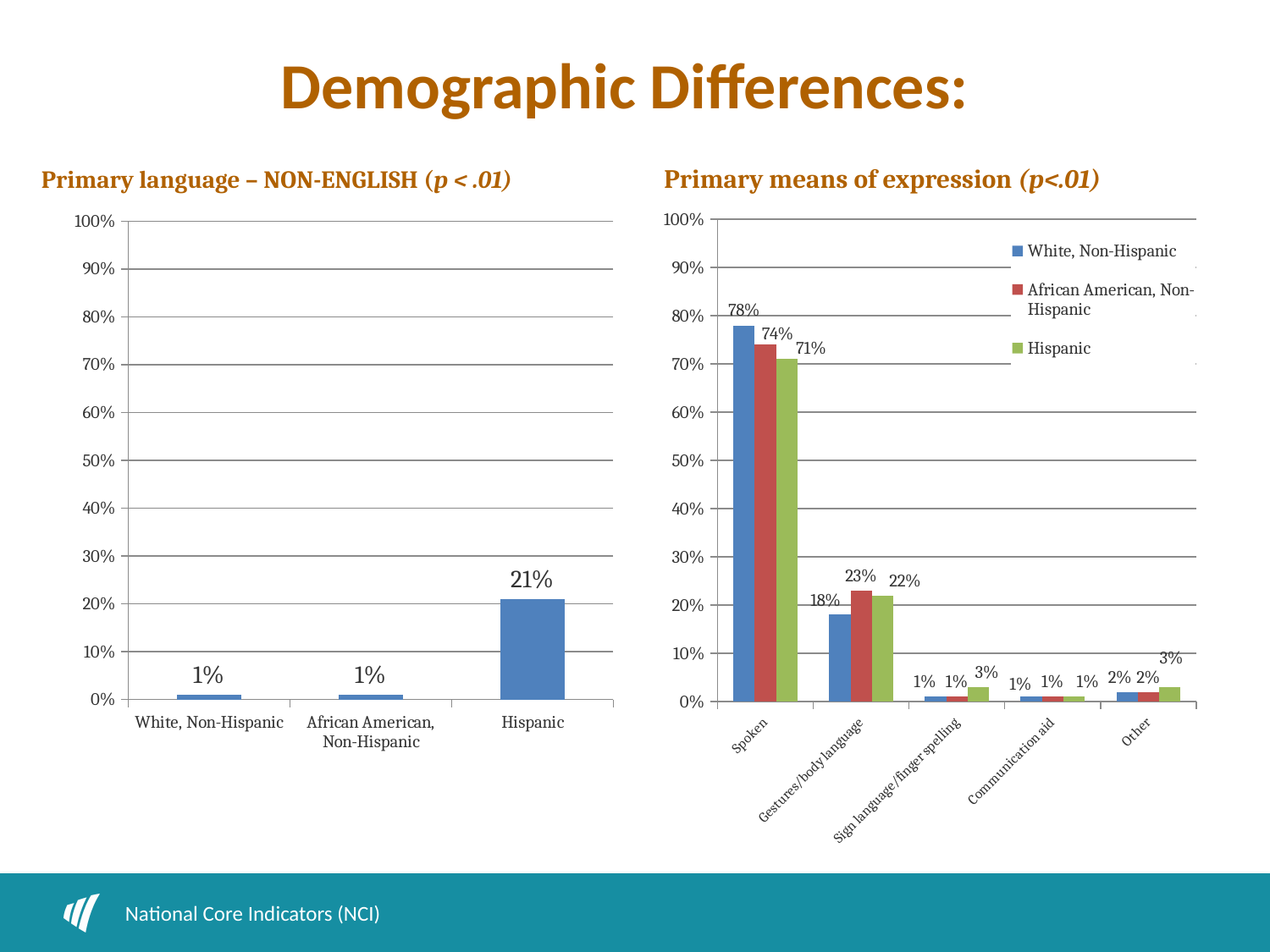
In the 'Primary means of expression' chart, what is the value for White, Non-Hispanic in the Spoken category? 78% What kind of chart is the 'Primary language – NON-ENGLISH' chart? Bar chart In the 'Primary language – NON-ENGLISH' chart, what is the difference between the Hispanic value and the White, Non-Hispanic value? 20% In the 'Primary means of expression' chart, what colour represents the Hispanic series? Green In the 'Primary language – NON-ENGLISH' chart, how many categories are shown on the x axis? 3 In the 'Primary language – NON-ENGLISH' chart, what is the value for Hispanic? 21% In the 'Primary means of expression' chart, what is the value for Hispanic in the Gestures/body language category? 22% In the 'Primary language – NON-ENGLISH' chart, which category has the highest value? Hispanic In the 'Primary means of expression' chart, what is the difference between the White, Non-Hispanic and Hispanic values for Spoken? 7% In the 'Primary means of expression' chart, which is larger for Gestures/body language: White, Non-Hispanic or African American, Non-Hispanic? African American, Non-Hispanic In the 'Primary means of expression' chart, how many series does the legend list? 3 In the 'Primary means of expression' chart, which series has the lowest value in the Spoken category? Hispanic